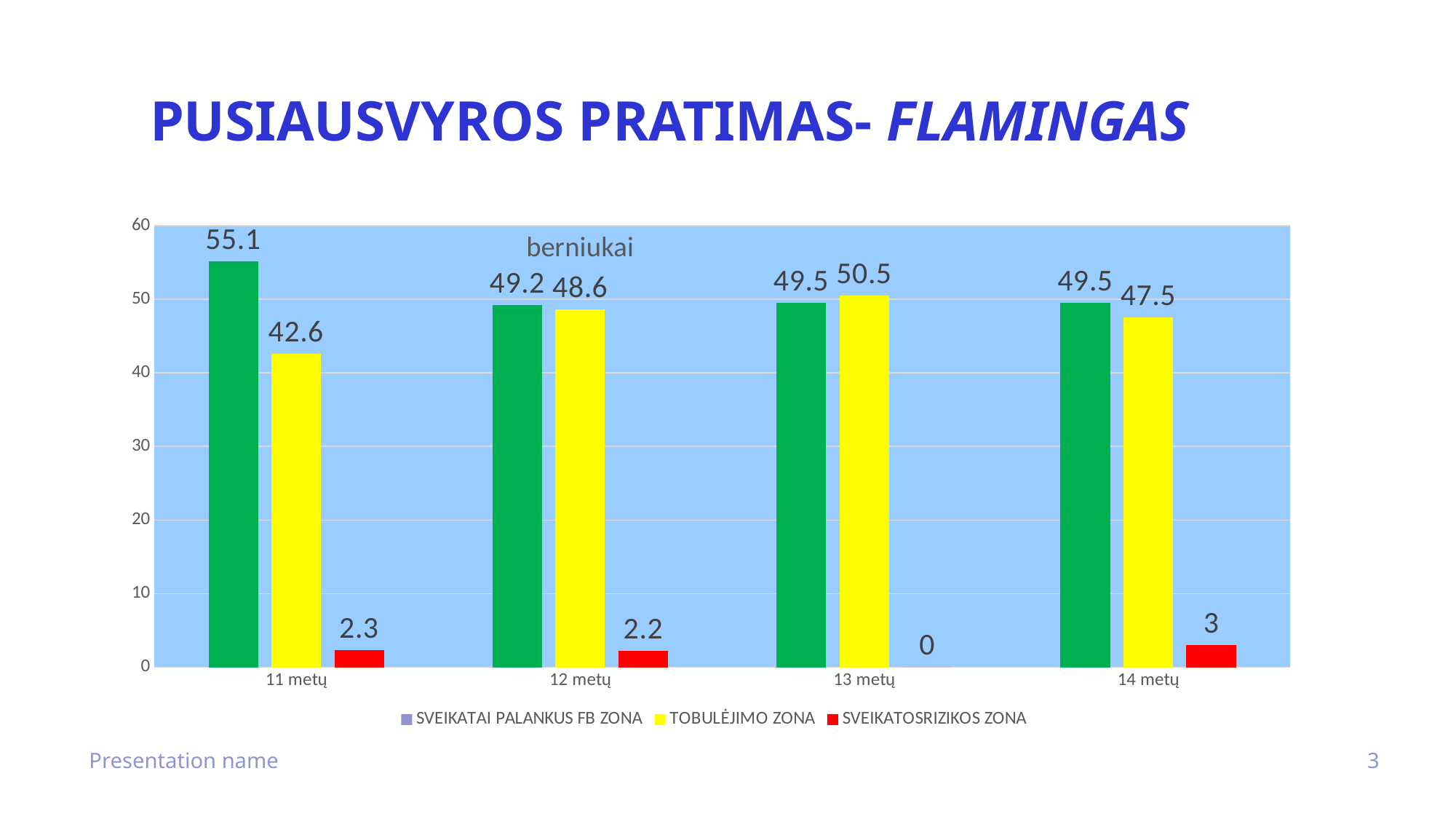
What is the value of SVEIKATOSRIZIKOS ZONA for 14 metų? 3 Which age group has the lowest value for TOBULĖJIMO ZONA? 11 metų What is the value of SVEIKATOSRIZIKOS ZONA for 13 metų? 0 What type of chart is shown on the slide? Bar chart What is the title shown inside the chart area? berniukai How many age groups are shown on the x axis? 4 How many series does the legend list? 3 What is the value of SVEIKATAI PALANKUS FB ZONA for 11 metų? 55.1 For 13 metų, which is larger: SVEIKATAI PALANKUS FB ZONA or TOBULĖJIMO ZONA? TOBULĖJIMO ZONA Which age group has the highest value for SVEIKATAI PALANKUS FB ZONA? 11 metų What is the value of TOBULĖJIMO ZONA for 13 metų? 50.5 What is the difference between the SVEIKATAI PALANKUS FB ZONA and TOBULĖJIMO ZONA values for 11 metų? 12.5